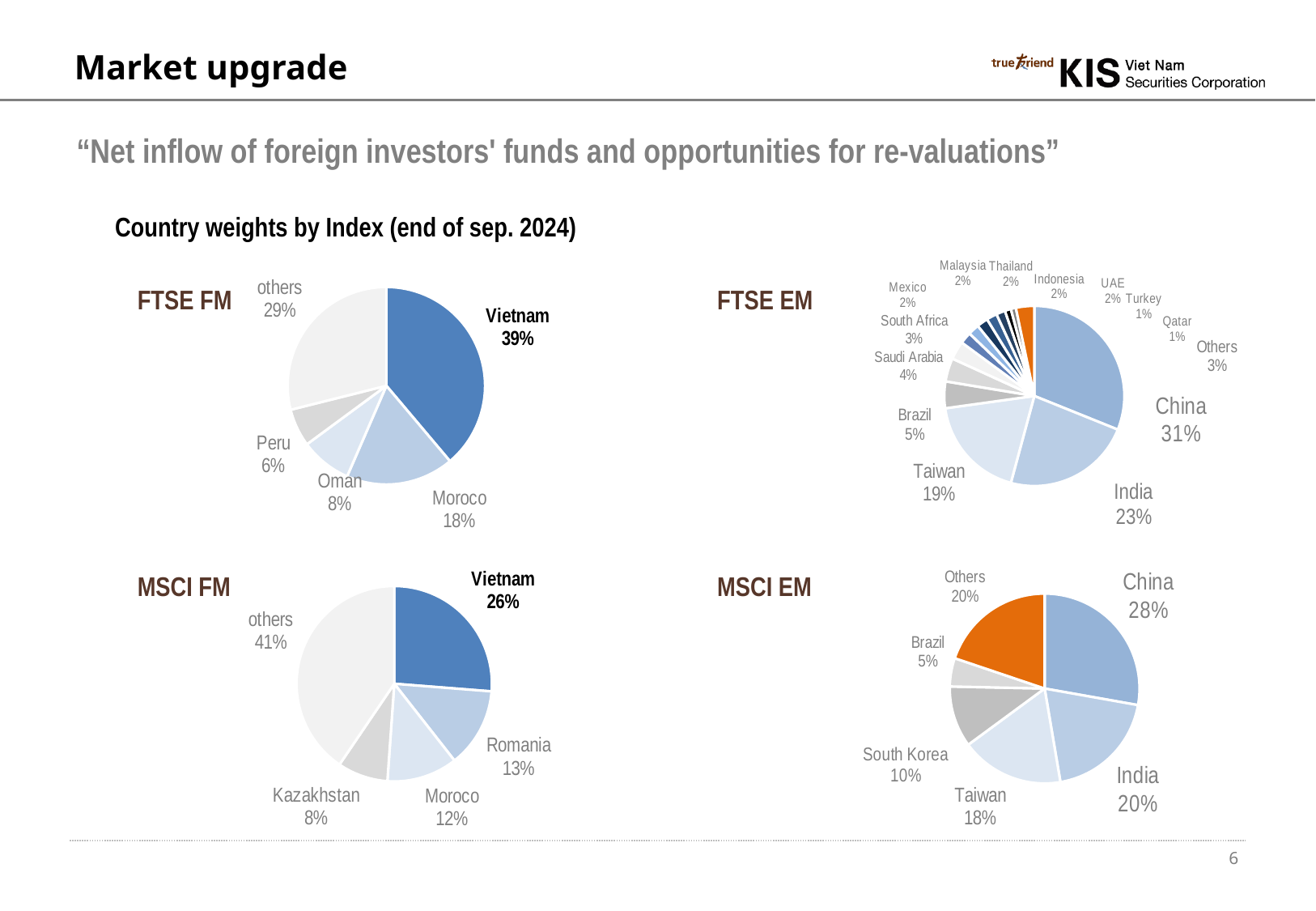
What is the title above the four charts? Country weights by Index (end of sep. 2024) In the FTSE EM chart, what is the weight of India? 23% How many slices does the MSCI FM pie chart have? 5 How many slices does the MSCI EM pie chart have? 6 In the MSCI FM chart, what is Vietnam's weight? 26% In the FTSE FM chart, which named country has the smallest weight? Peru In the FTSE FM chart, what is Vietnam's weight? 39% In the MSCI EM chart, which is larger, the weight of Taiwan or the weight of India? India In the MSCI EM chart, which country has the largest weight? China In the MSCI EM chart, what is the weight of South Korea? 10% What type of chart is used for the FTSE EM index? Pie chart In the FTSE FM chart, what is the difference between Vietnam's weight and Moroco's weight? 21 percentage points